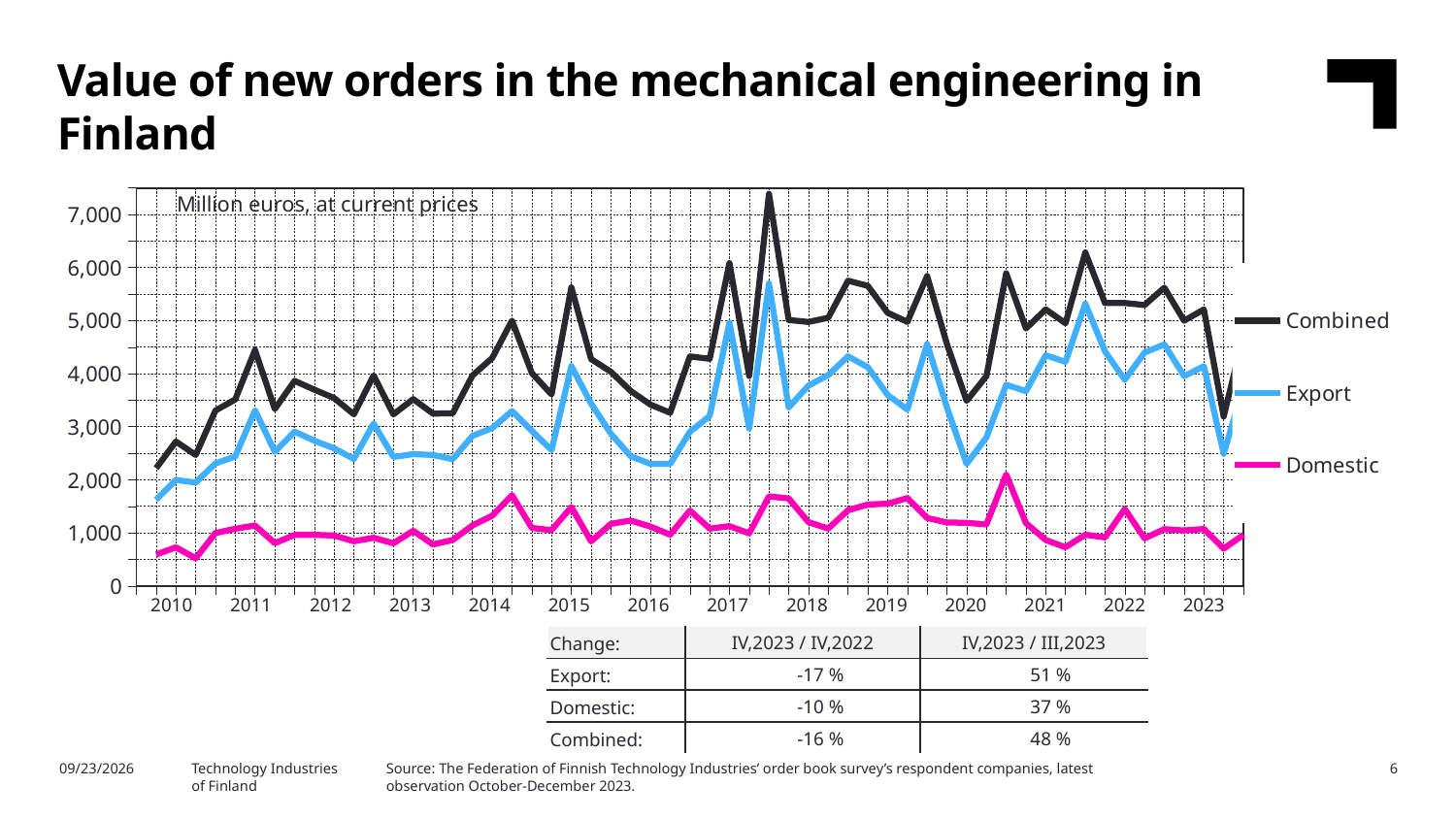
Is the first plotted value of the Export series in 2010 greater or less than 2,000? less What unit is stated in the label inside the chart area? Million euros, at current prices Which series is plotted lowest across the whole chart? Domestic Is the peak value of the Combined series in 2017 greater or less than 7,000? greater What colour is the Domestic line in the chart? Pink How many series does the chart's legend list? 3 Around 2017, which series reaches a higher value: Export or Domestic? Export How many years are labelled on the x axis? 14 Is the first plotted value of the Domestic series in 2010 greater or less than 1,000? less What kind of chart is shown on the slide? Line chart Which series is plotted highest across the whole chart? Combined